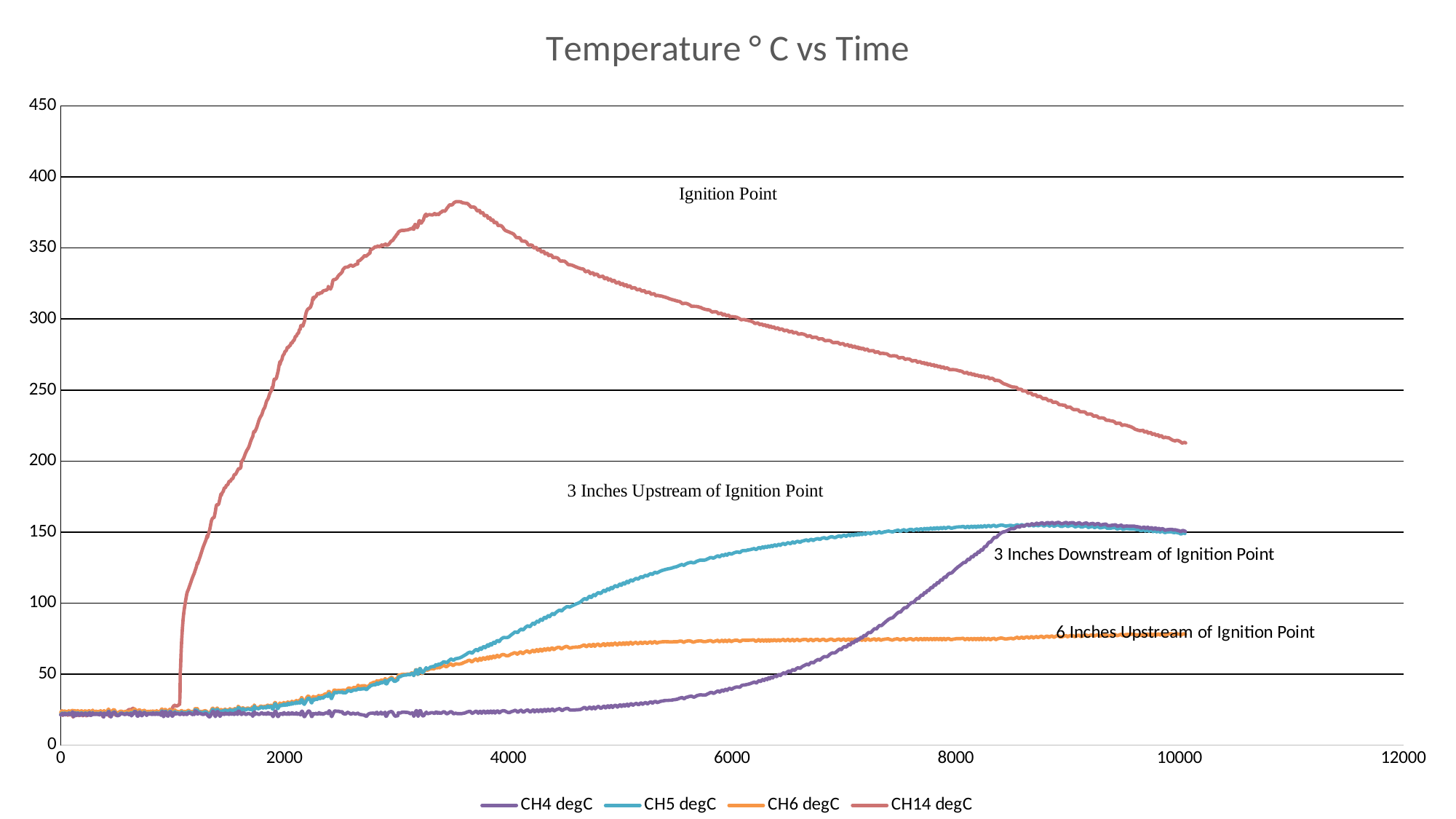
Is the peak value of CH14 degC greater or less than 350? greater What kind of chart is shown on the slide? line chart Which annotation on the chart labels the CH14 degC line? Ignition Point Is the value of CH14 degC at time 10000 greater or less than 200? greater Is the value of CH6 degC at time 10000 greater or less than 100? less How many series does the legend list? 4 Which series has the lowest value at time 4000? CH4 degC What is the title of the chart? Temperature ° C vs Time At time 6000, which is higher, CH5 degC or CH6 degC? CH5 degC Does the CH14 degC line rise or fall between time 4000 and time 10000? fall Which series reaches the highest temperature on the chart? CH14 degC